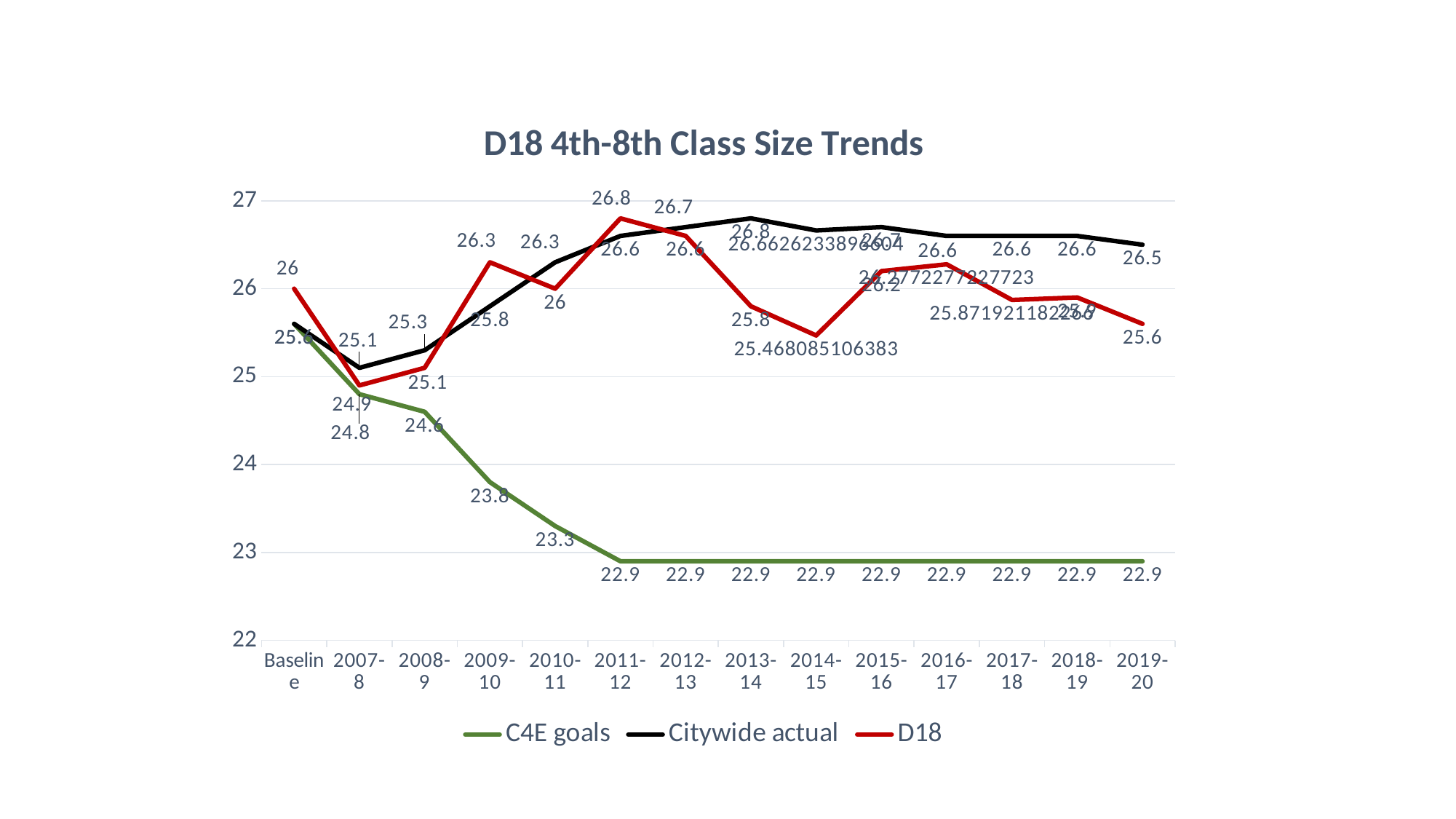
What is the C4E goals value for 2009-10? 23.8 In 2019-20, which is larger: Citywide actual or D18? Citywide actual How many series does the legend list? 3 In which year does the D18 series reach its highest value? 2011-12 Is the Citywide actual value for 2011-12 greater or less than 26? greater What is the D18 value at Baseline? 26 What is the difference between the D18 value in 2011-12 and the D18 value in 2019-20? 1.2 Do the C4E goals values rise or fall from Baseline to 2011-12? fall What is the title of the chart? D18 4th-8th Class Size Trends What is the Citywide actual value for 2019-20? 26.5 What kind of chart is shown on the slide? line chart How many categories are on the x axis? 14